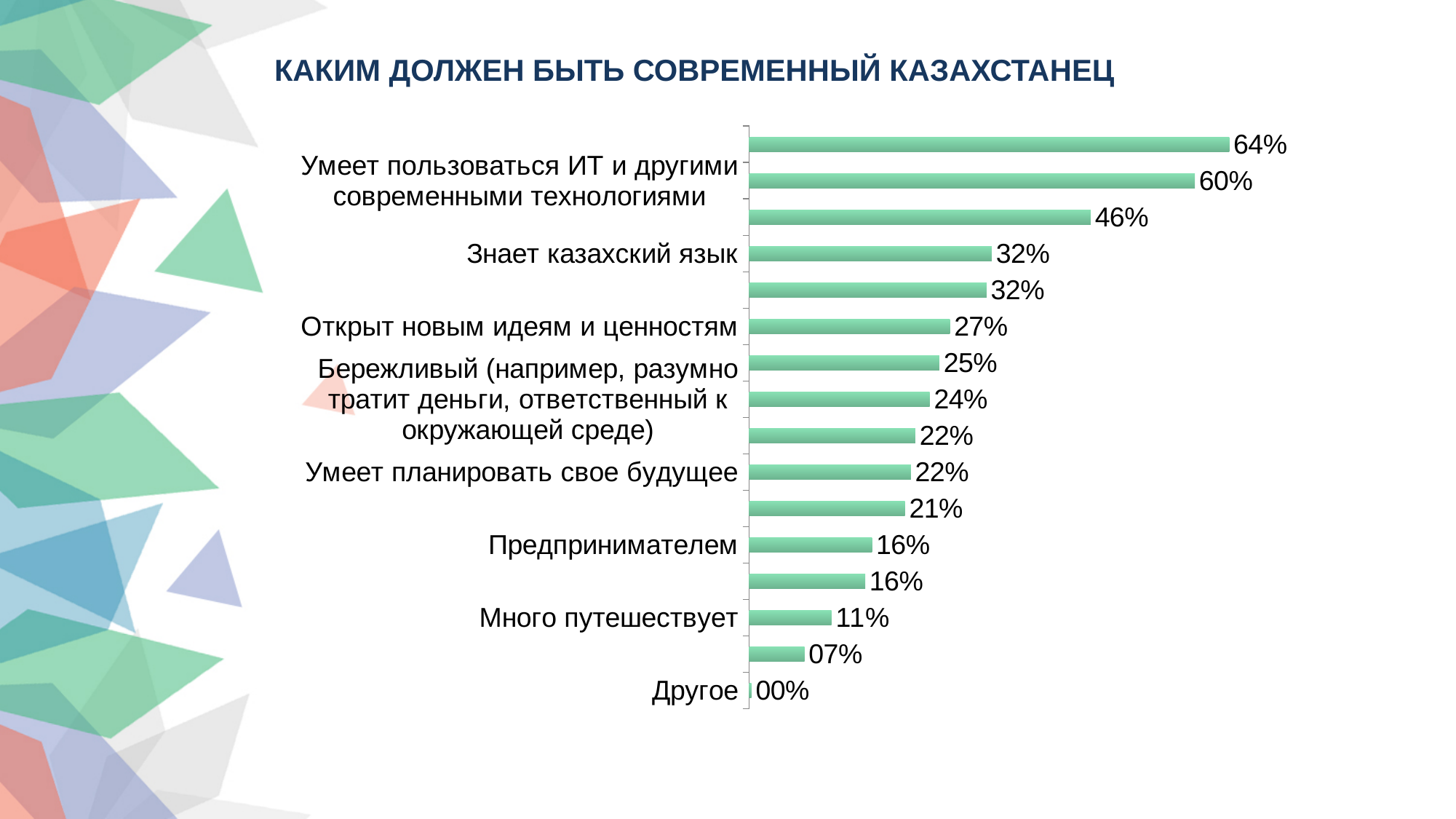
What is the value for "Умеет планировать свое будущее"? 22% What is the value for "Много путешествует"? 11% What is the value for "Другое"? 00% Which labelled category has the lowest value? Другое What kind of chart is shown on the slide? Bar chart What is the difference between the values for "Знает казахский язык" and "Много путешествует"? 21% What is the highest value shown on the chart? 64% What is the value for "Предпринимателем"? 16% What is the value for "Знает казахский язык"? 32% Which is larger: the value for "Открыт новым идеям и ценностям" or for "Предпринимателем"? Открыт новым идеям и ценностям What is the value for "Открыт новым идеям и ценностям"? 27% How many bars are plotted on the chart? 16